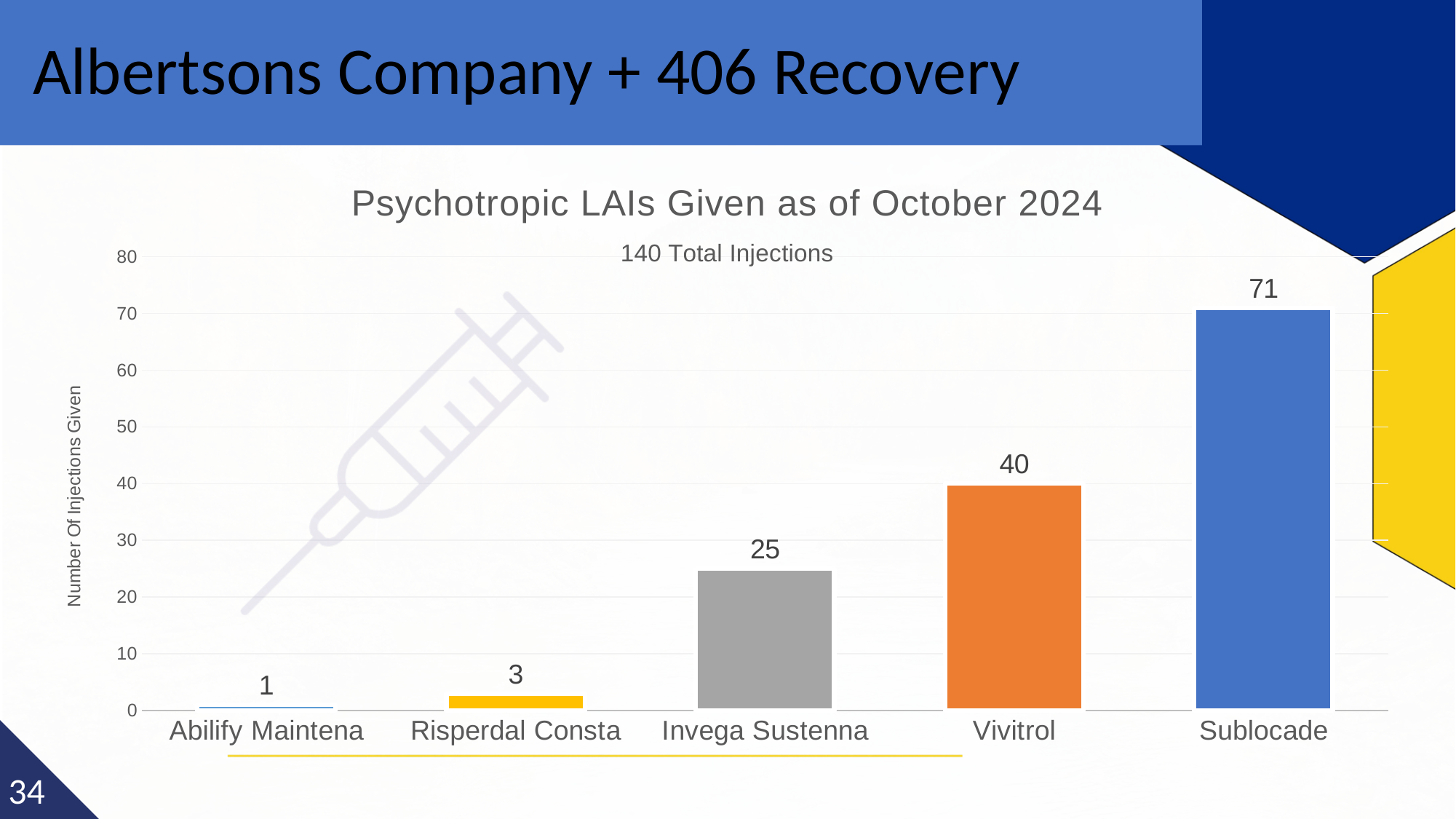
What kind of chart is shown on the slide? Bar chart How many injections were given for Sublocade? 71 How many injections were given for Risperdal Consta? 3 What is the difference between the number of injections for Sublocade and Vivitrol? 31 How many medications are shown on the x axis of the chart? 5 How many injections were given for Vivitrol? 40 Do the values rise or fall moving from left to right along the x axis? Rise What is the title of the chart? Psychotropic LAIs Given as of October 2024 How many injections were given for Invega Sustenna? 25 Which medication has the lowest number of injections given? Abilify Maintena Which has more injections given, Invega Sustenna or Vivitrol? Vivitrol Which medication has the highest number of injections given? Sublocade